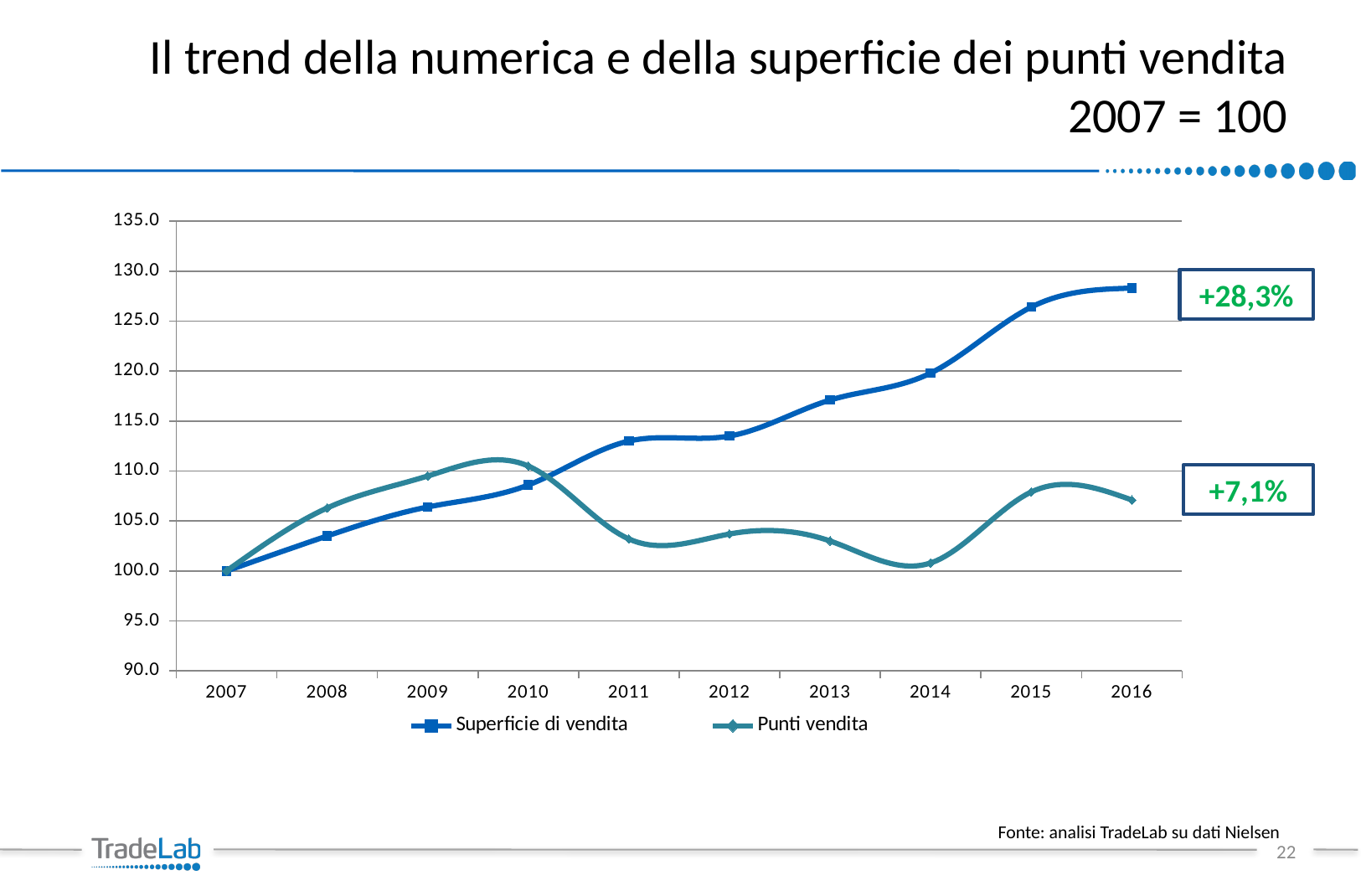
What kind of chart is shown on the slide? line chart In 2016, which series has the higher value, Superficie di vendita or Punti vendita? Superficie di vendita In which year does Superficie di vendita reach its highest value? 2016 Is the value for Punti vendita in 2014 greater or less than 105.0? less Is the value for Punti vendita in 2010 greater or less than 105.0? greater What percentage change is annotated next to the Punti vendita line? +7,1% How many series does the legend list? 2 What is the value of Superficie di vendita in 2007? 100.0 In 2009, which series has the higher value, Superficie di vendita or Punti vendita? Punti vendita Is the value for Superficie di vendita in 2016 greater or less than 125.0? greater How many years are plotted along the x axis? 10 Does the Superficie di vendita series rise or fall from 2007 to 2016? rise